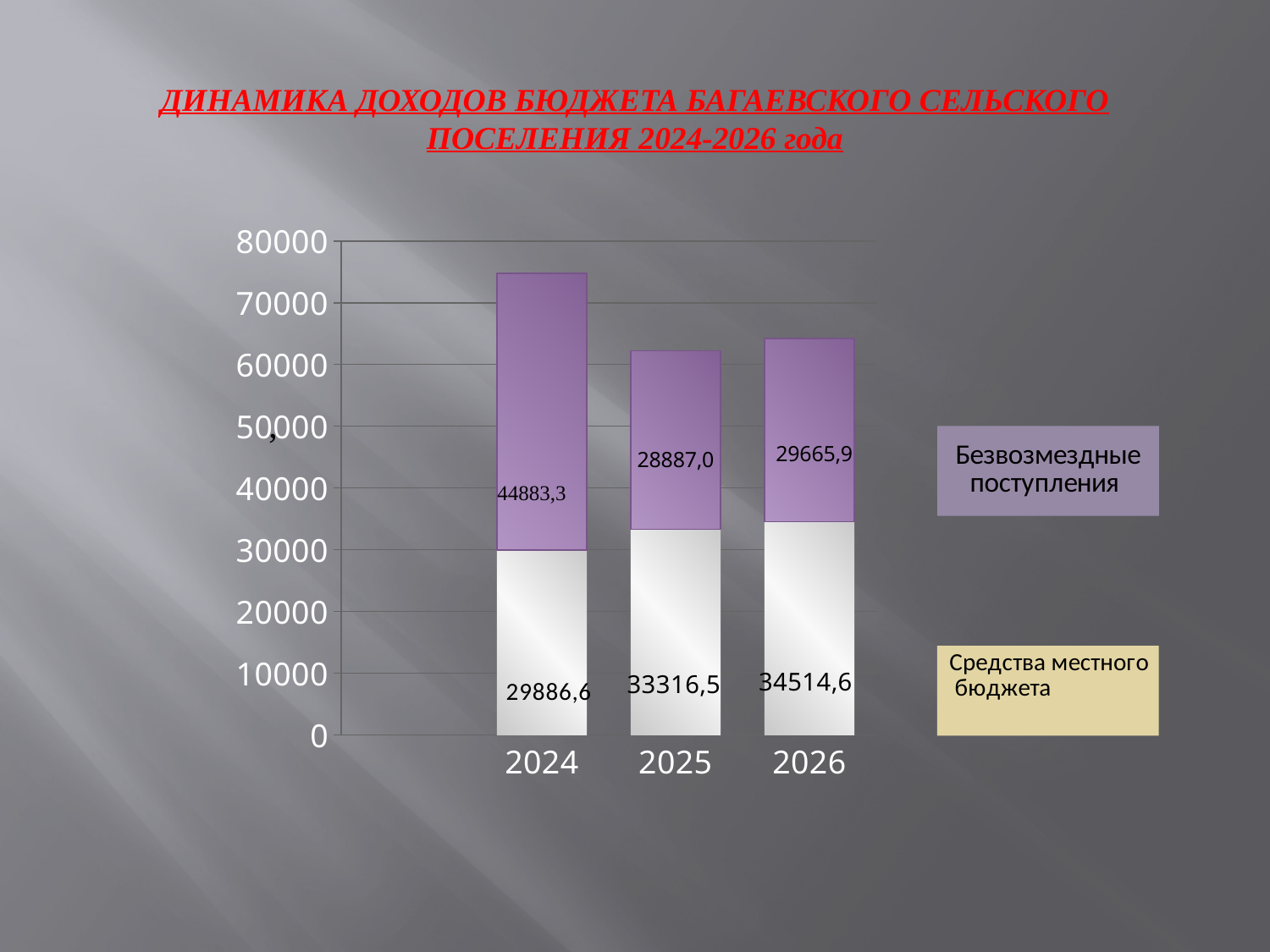
Is the total of the stacked bar for 2025 greater or less than 70000? less What is the value of Средства местного бюджета for 2024? 29886,6 In which year is Безвозмездные поступления highest? 2024 What is the value of Безвозмездные поступления for 2026? 29665,9 What is the difference between Средства местного бюджета in 2026 and in 2024? 4628,0 What kind of chart is shown on the slide? stacked bar chart How many years are shown on the x axis of the chart? 3 In which year is Средства местного бюджета lowest? 2024 What is the difference between Безвозмездные поступления in 2024 and in 2025? 15996,3 What is the total of the stacked bar for 2024? 74769,9 What is the value of Безвозмездные поступления for 2025? 28887,0 Which is larger in 2025: Средства местного бюджета or Безвозмездные поступления? Средства местного бюджета